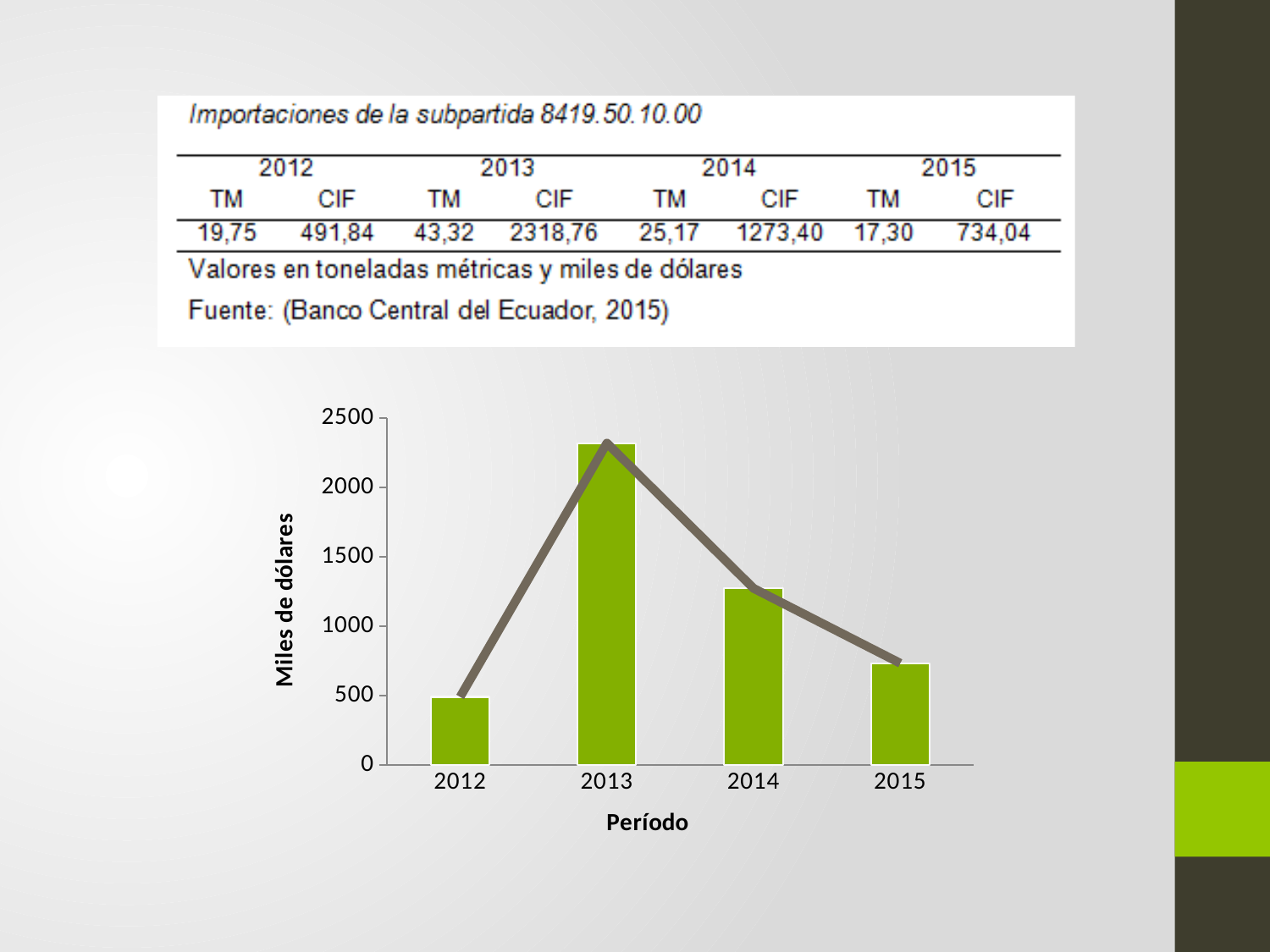
Is the value for 2015 in the chart greater or less than 1000? less What kind of chart is shown on the slide? bar chart with a line Do the values in the chart rise or fall from 2013 to 2015? fall What is the label of the vertical axis of the chart? Miles de dólares Which year has the highest bar in the chart? 2013 Is the value for 2013 in the chart greater or less than 2000? greater Which year has the lowest bar in the chart? 2012 According to the table on the slide, what is the CIF value for 2013? 2318,76 How many periods (years) are shown on the x axis of the chart? 4 Is the value for 2014 in the chart greater or less than 1000? greater Which year has a larger value in the chart, 2014 or 2015? 2014